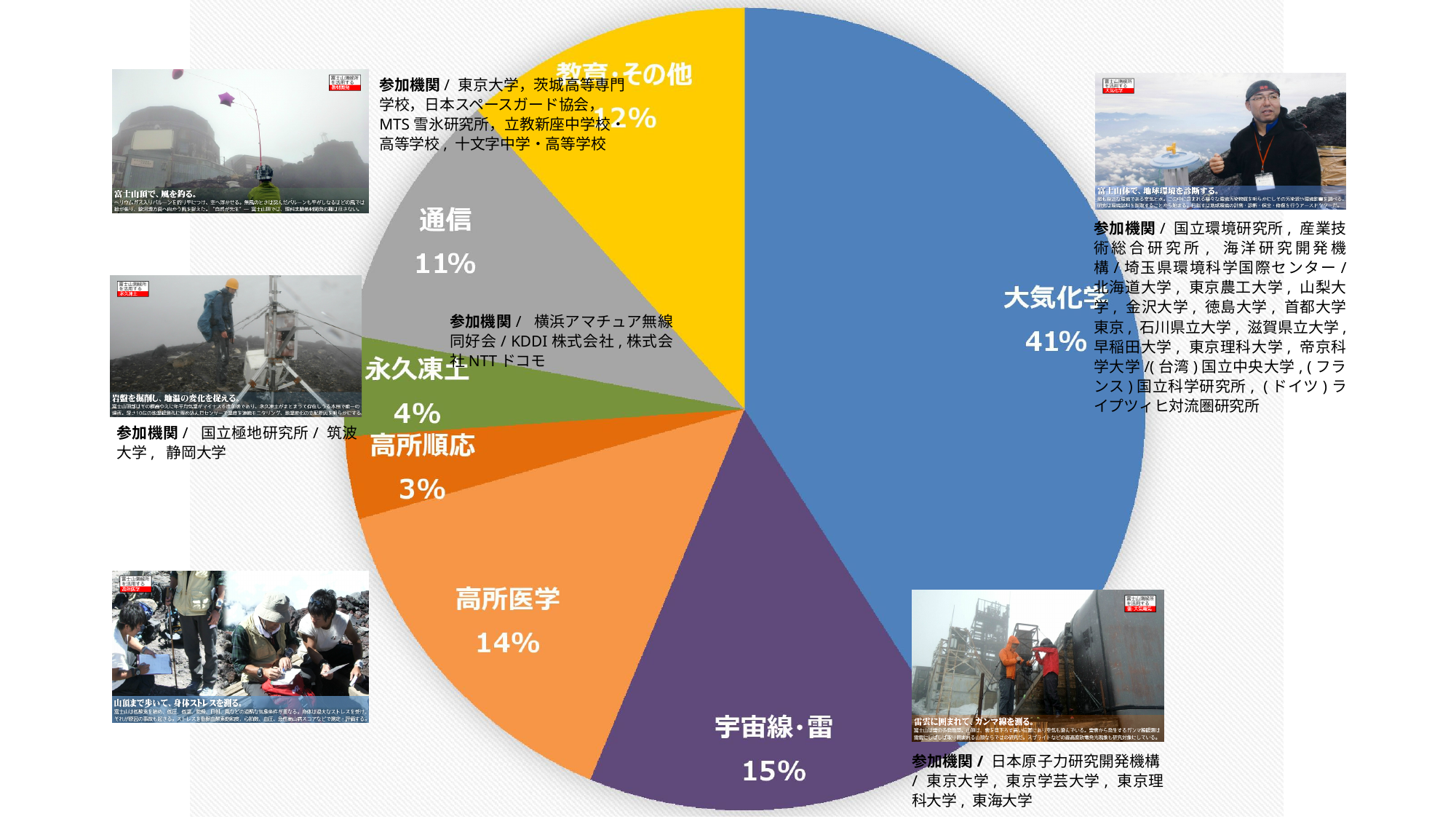
How many slices does the pie chart have? 7 What colour is the 大気化学 slice? blue What percentage does the 高所医学 slice represent? 14% What is the difference in percentage points between the 大気化学 slice and the 宇宙線・雷 slice? 26 Which category has the smallest share of the pie? 高所順応 What percentage does the 大気化学 slice represent? 41% Which slice is larger, 通信 or 高所医学? 高所医学 What percentage does the 永久凍土 slice represent? 4% What percentage does the 通信 slice represent? 11% What percentage does the 宇宙線・雷 slice represent? 15% What kind of chart is shown on the slide? pie chart Which category has the largest share of the pie? 大気化学